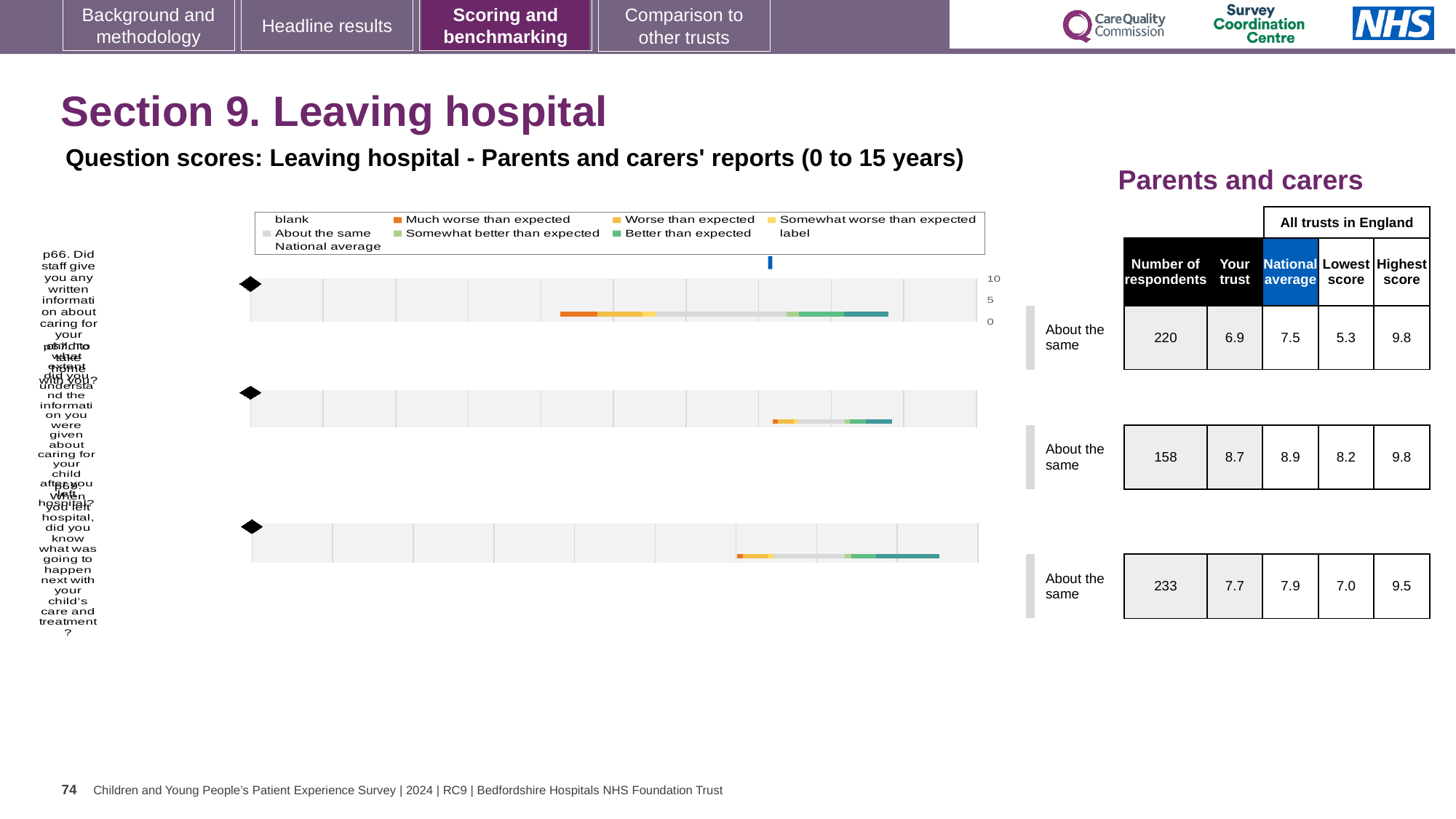
What kind of chart is used to show the question scores on this slide? bar chart For the first question row, what is the difference between the national average and the 'Your trust' score? 0.6 In the table, what is the highest score for the third question row? 9.5 In the table, what is the 'Your trust' score for the second question row? 8.7 Which question row has the highest 'Your trust' score in the table? the second row (8.7) What benchmark category is shown next to each of the three question rows? About the same Which question row has the lowest number of respondents in the table? the second row (158) How many question rows (charts) are shown on the slide? 3 In the table, what is the number of respondents for the first question row? 220 In the legend, what colour represents 'Much worse than expected'? orange For the third question row, which is larger: the 'Your trust' score or the national average? National average In the table, what is the lowest score for the first question row? 5.3